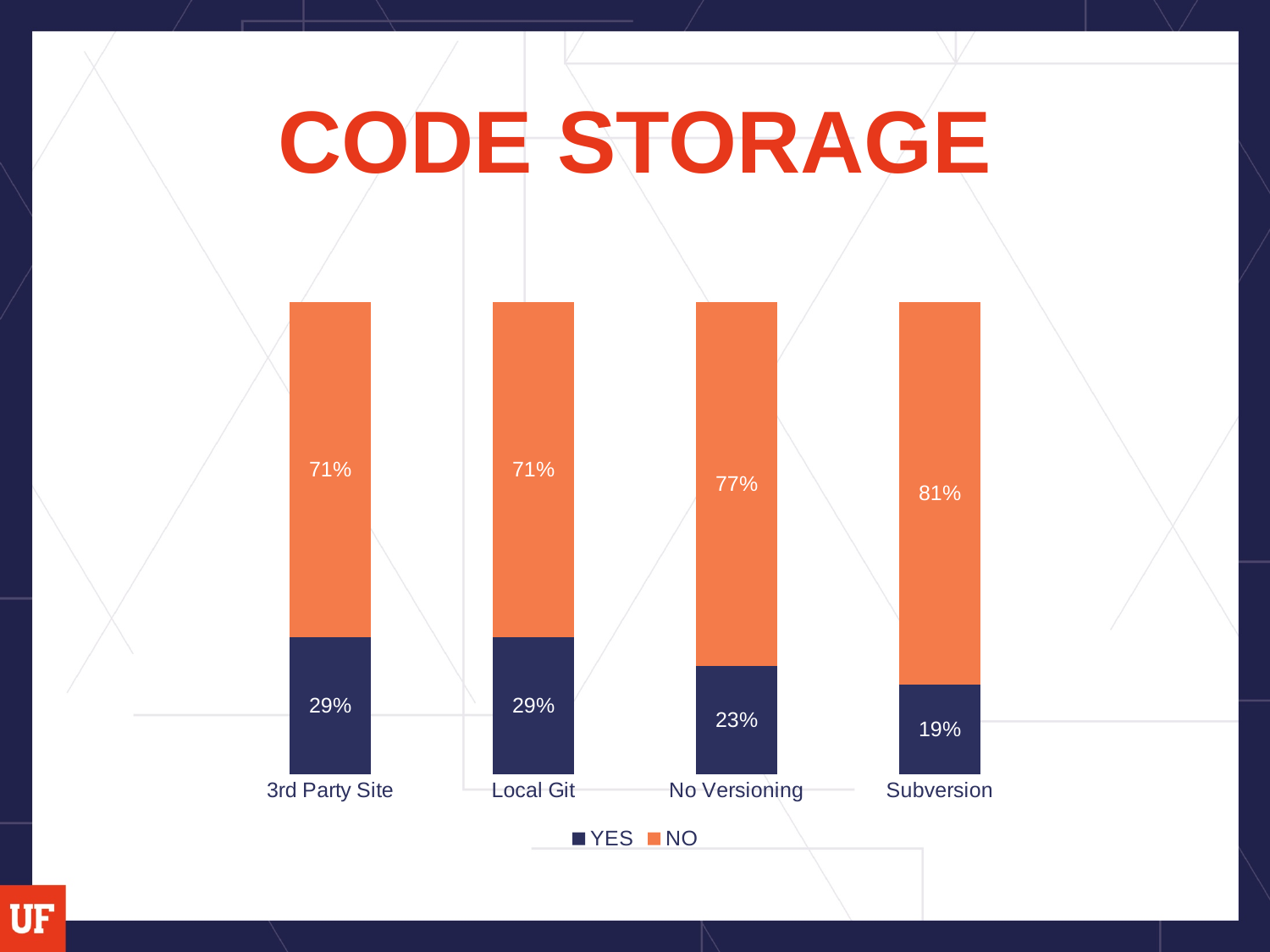
What is the difference between the NO value for Subversion and the NO value for 3rd Party Site? 10% Which is larger, the YES value for No Versioning or the YES value for Subversion? No Versioning How many series does the legend list? 2 Which category has the lowest YES value? Subversion What is the YES value for Subversion? 19% Which category has the highest NO value? Subversion What is the NO value for 3rd Party Site? 71% What is the title of the chart? CODE STORAGE What is the YES value for Local Git? 29% What is the NO value for No Versioning? 77% How many categories are shown on the x axis? 4 What kind of chart is shown on the slide? Stacked bar chart